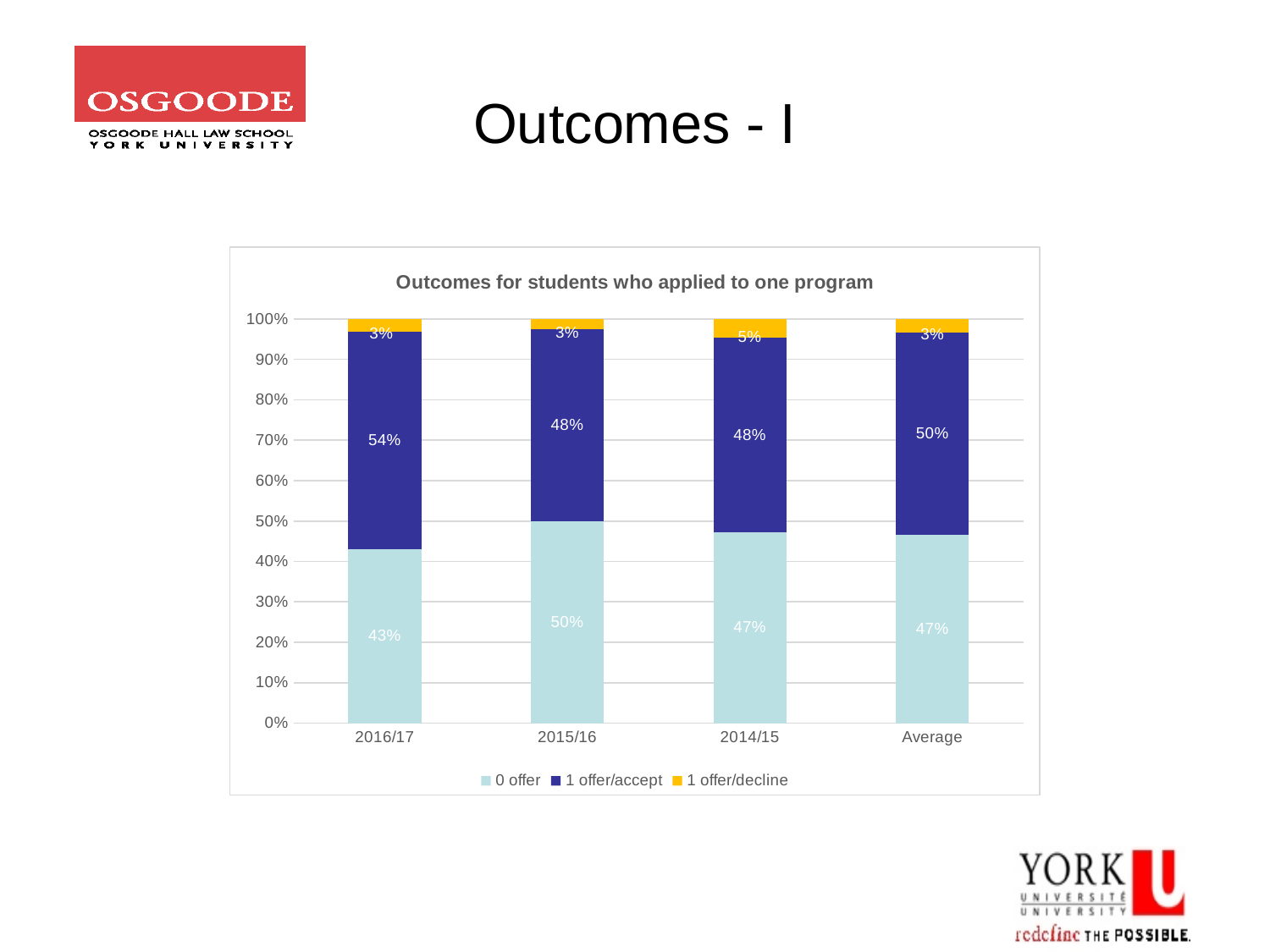
What is the value for 0 offer in 2015/16? 50% What is the difference between the 1 offer/accept and 0 offer values in 2016/17? 11% Which category has the highest value for 1 offer/accept? 2016/17 What kind of chart is shown on the slide? stacked bar chart How many series does the legend list? 3 What is the value for 1 offer/accept in the Average category? 50% What is the title of the chart? Outcomes for students who applied to one program What is the value for 1 offer/accept in 2016/17? 54% Which category has the lowest value for 0 offer? 2016/17 How many categories are shown on the x axis? 4 Which is larger in 2014/15: the 0 offer value or the 1 offer/accept value? 1 offer/accept What is the value for 1 offer/decline in 2014/15? 5%